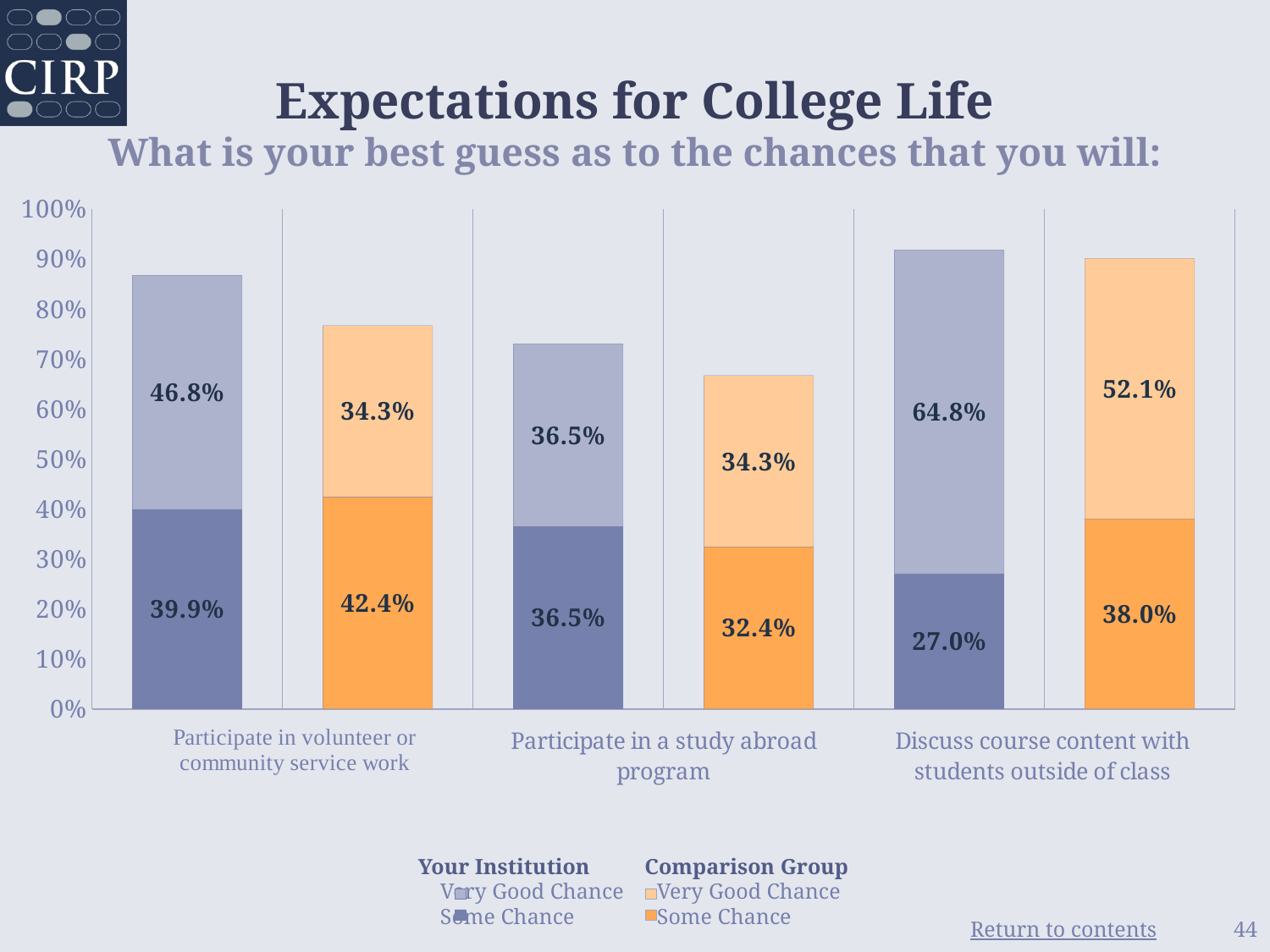
How many series does the legend list? 4 How many categories are shown on the x axis? 3 What is the total of the Comparison Group stacked bar for 'Discuss course content with students outside of class'? 90.1% What is the total of the Your Institution stacked bar for 'Participate in a study abroad program'? 73.0% What kind of chart is shown on the slide? Stacked bar chart Which category has the lowest Comparison Group 'Some Chance' value? Participate in a study abroad program What is the difference between the Your Institution and Comparison Group 'Very Good Chance' values for 'Discuss course content with students outside of class'? 12.7% Which category has the highest Your Institution 'Very Good Chance' value? Discuss course content with students outside of class What is the Comparison Group 'Some Chance' value for 'Participate in a study abroad program'? 32.4% What is the Your Institution 'Very Good Chance' value for 'Participate in volunteer or community service work'? 46.8% For 'Participate in volunteer or community service work', which is larger: the Your Institution 'Some Chance' value or the Comparison Group 'Some Chance' value? Comparison Group What is the Your Institution 'Some Chance' value for 'Discuss course content with students outside of class'? 27.0%